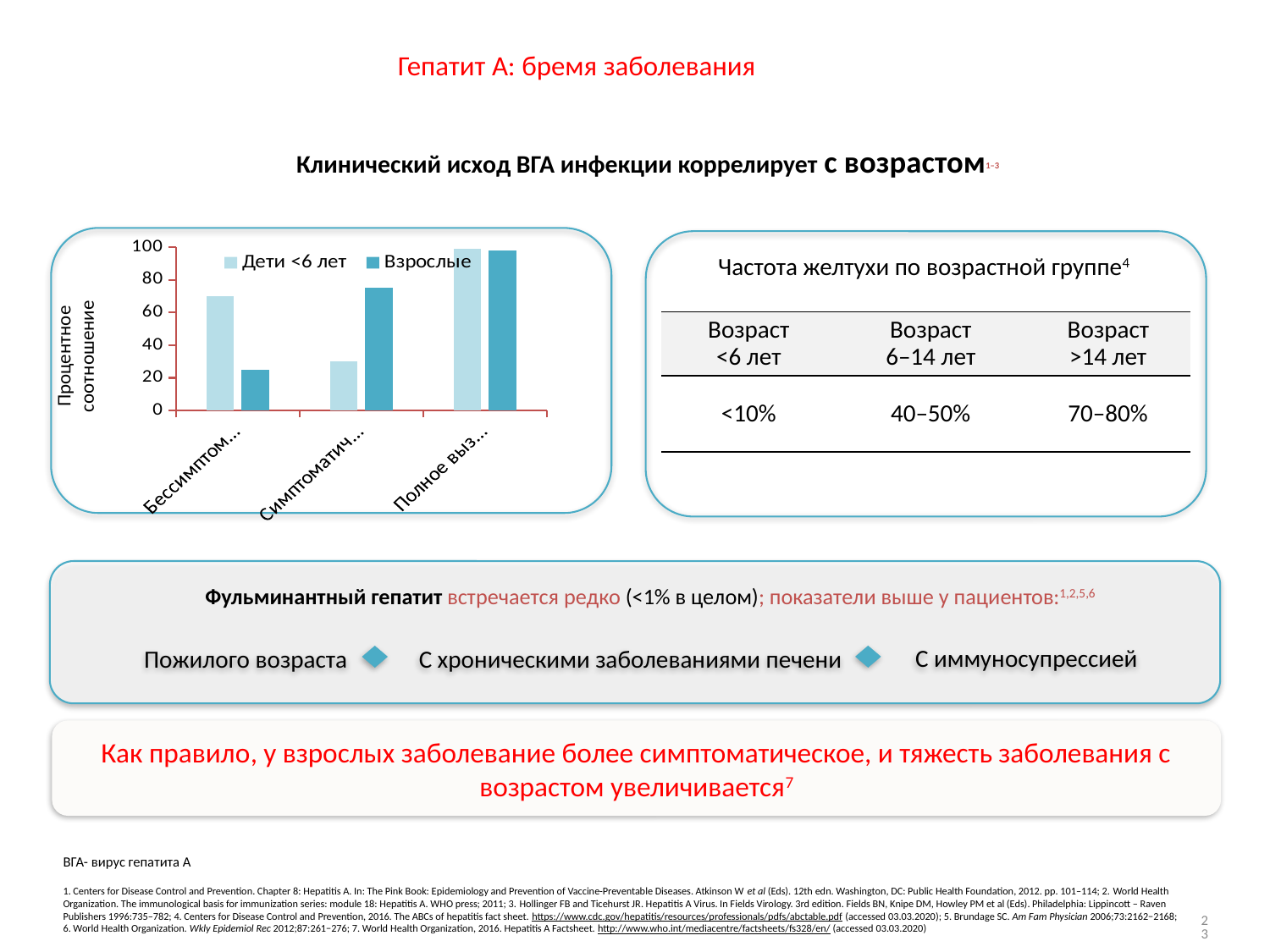
In the bar chart, for the second category from the left (Симптоматич...), is the value for Дети <6 лет greater or less than 40? less In the bar chart, for the first category from the left (Бессимптом...), is the value for Дети <6 лет greater or less than 60? greater What is the label of the y axis of the bar chart? Процентное соотношение How many series does the legend of the bar chart list? 2 In the bar chart, for the second category from the left (Симптоматич...), is the value for Взрослые greater or less than 60? greater In the bar chart, for the second category from the left (Симптоматич...), which series has the larger value, Дети <6 лет or Взрослые? Взрослые How many categories are shown along the x axis of the bar chart? 3 What kind of chart is shown on the left of the slide? bar chart What are the two series named in the legend of the bar chart? Дети <6 лет and Взрослые In the bar chart, for the first category from the left (Бессимптом...), which series has the larger value, Дети <6 лет or Взрослые? Дети <6 лет In the bar chart, for which category is the Взрослые series lowest? the first category (Бессимптом...)